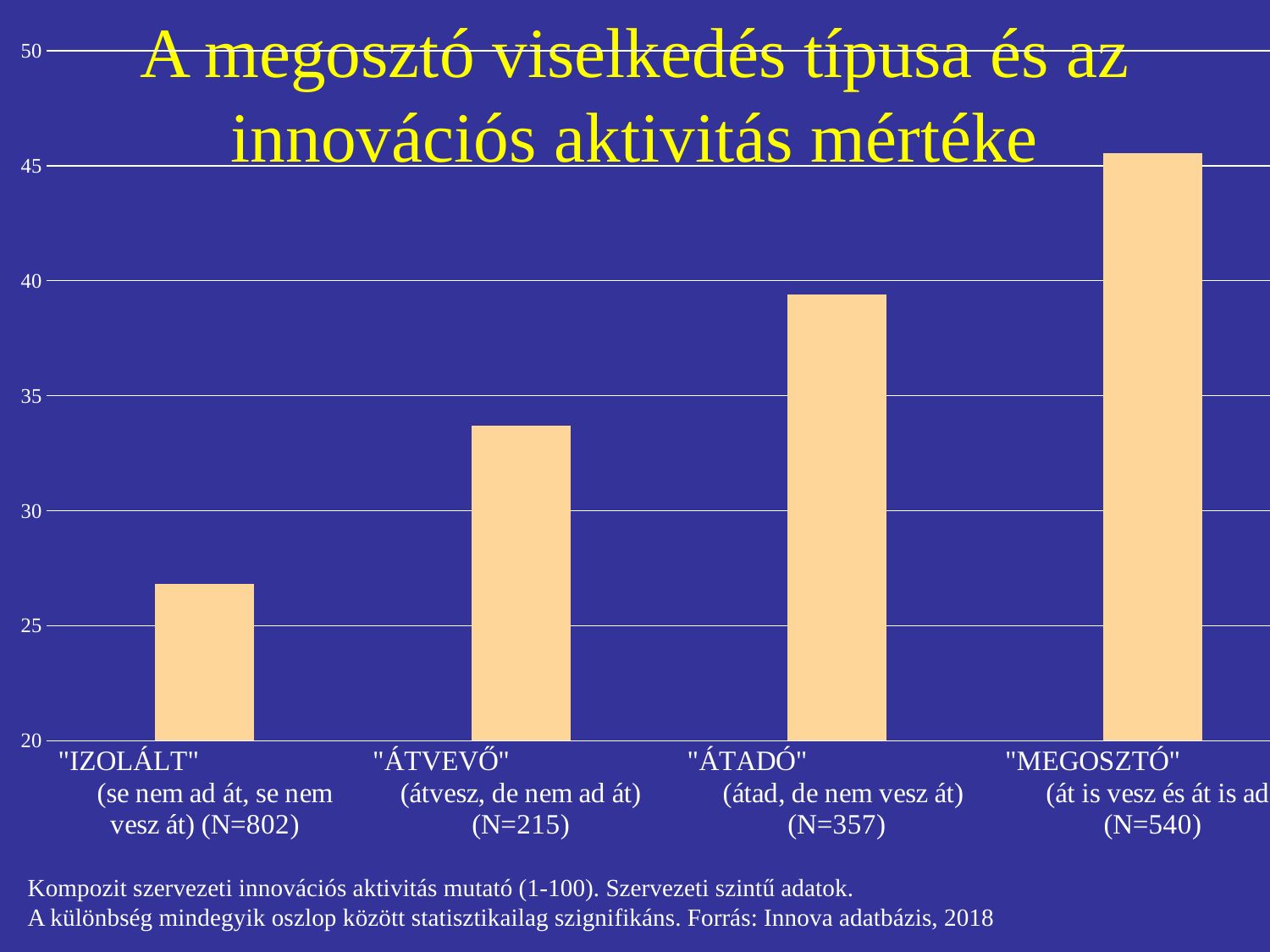
Is the value for "ÁTVEVŐ" greater or less than 30? greater Is the value for "ÁTADÓ" greater or less than 40? less Which is larger, the value for "ÁTVEVŐ" or the value for "ÁTADÓ"? "ÁTADÓ" How many categories (bars) does the chart show? 4 What type of chart is shown on the slide? bar chart Do the values rise or fall from left to right across the categories? rise Which category has the lowest value? "IZOLÁLT" Which category has the highest value? "MEGOSZTÓ" What is the sample size (N) shown for the "IZOLÁLT" category? N=802 What is the title of the chart? A megosztó viselkedés típusa és az innovációs aktivitás mértéke Is the value for "IZOLÁLT" greater or less than 30? less